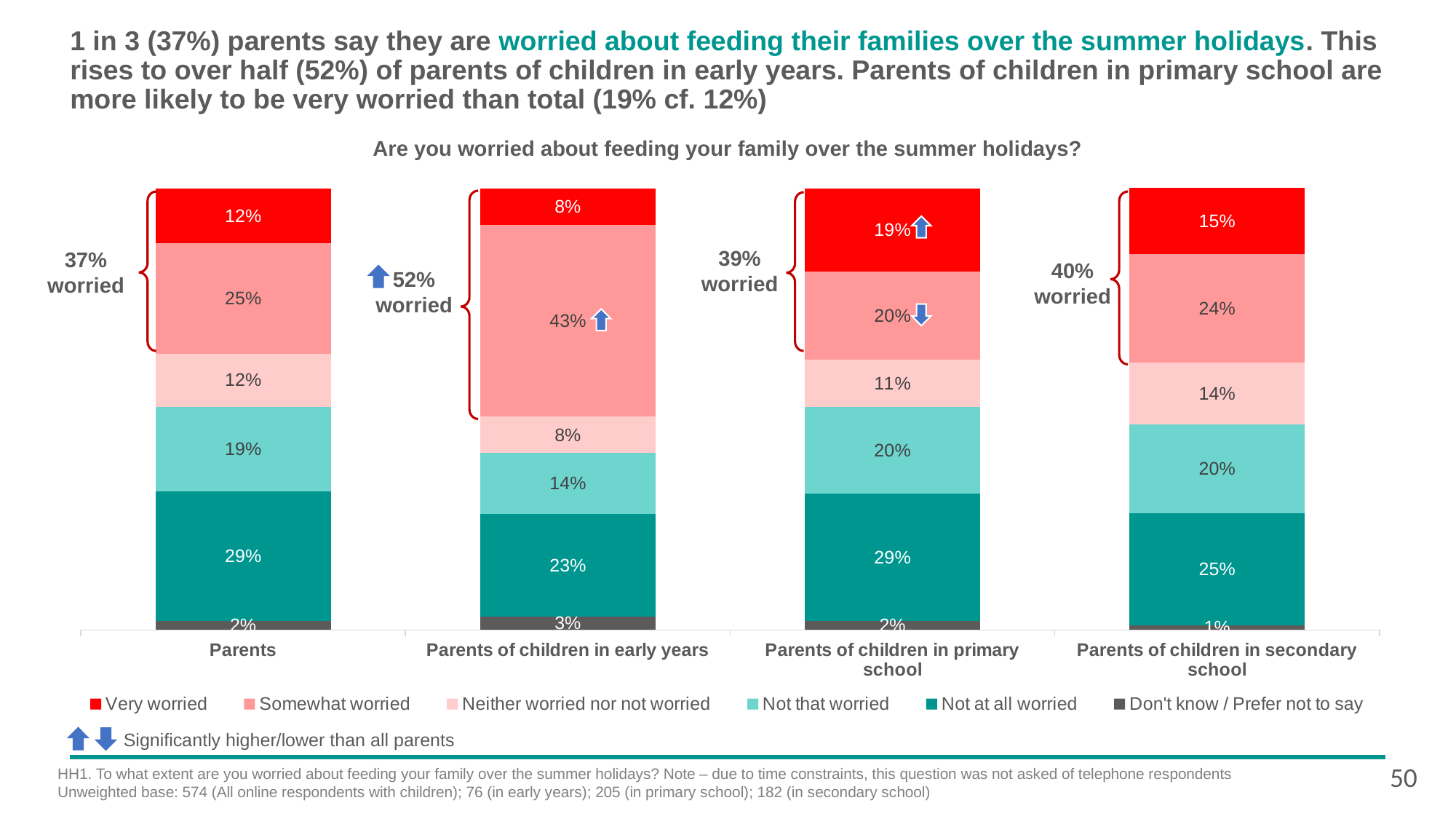
What percentage of parents of children in early years are 'Somewhat worried'? 43% Which is larger: the 'Not that worried' share for all parents or for parents of children in early years? All parents What type of chart is shown on the slide? Stacked bar chart How many response categories does the legend list? 6 What percentage of parents of children in secondary school are 'Not at all worried'? 25% What percentage of all parents are 'Very worried' about feeding their family over the summer holidays? 12% How many percentage points higher is the 'Very worried' share for parents of children in primary school than for all parents? 7 percentage points What percentage of parents of children in primary school answered 'Neither worried nor not worried'? 11% Which group has the lowest 'Very worried' percentage? Parents of children in early years Which group has the highest 'Somewhat worried' percentage? Parents of children in early years How many parent groups are shown on the x axis? 4 According to the bracket annotation, what combined percentage of parents of children in secondary school are worried? 40% worried